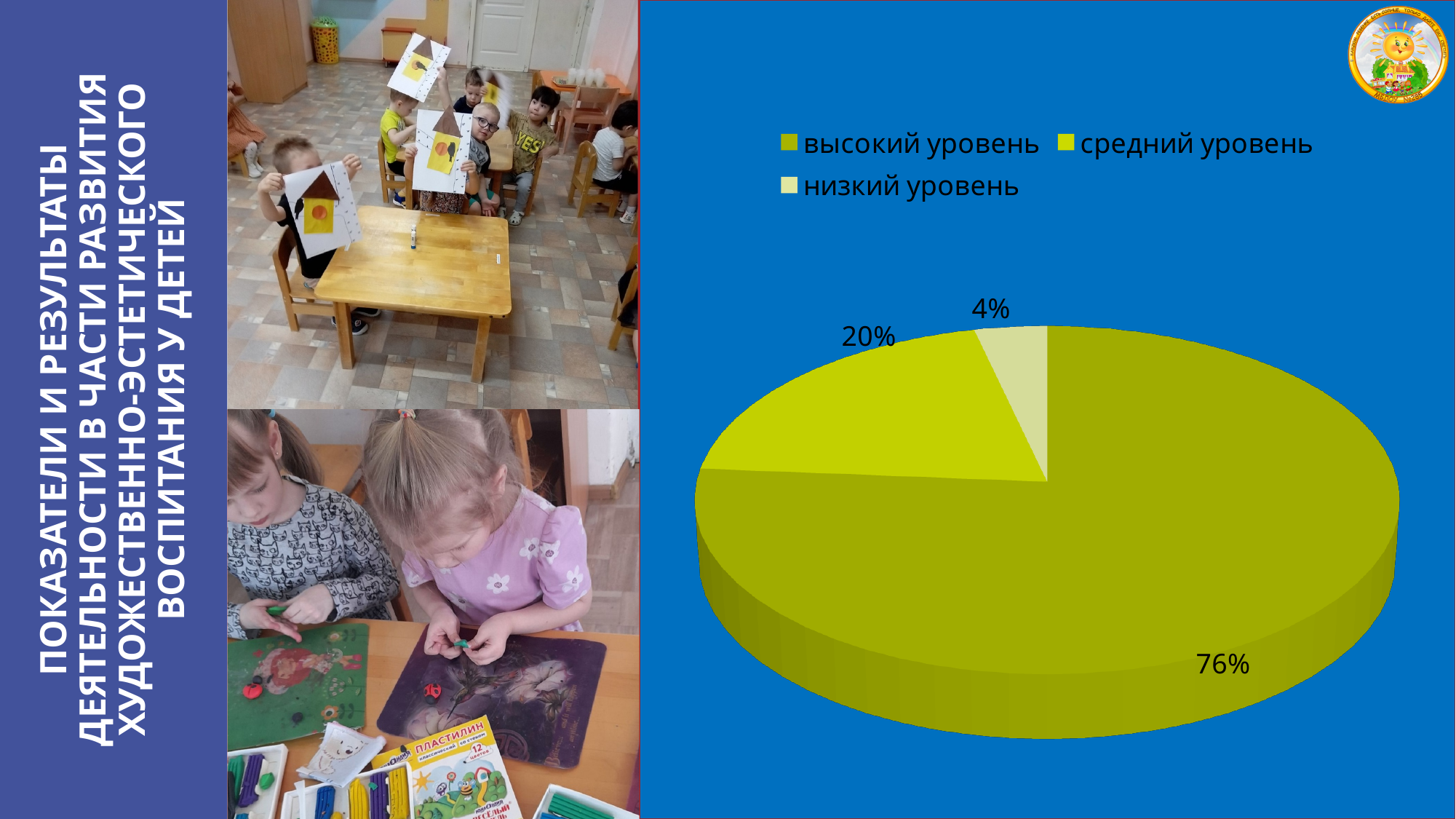
Which category has the largest share of the pie? высокий уровень What percentage is shown for средний уровень? 20% What is the difference in percentage points between средний уровень and низкий уровень? 16 Which category has the smallest share of the pie? низкий уровень What kind of chart is shown on the slide? pie chart What percentage is shown for высокий уровень? 76% What percentage is shown for низкий уровень? 4% How many entries does the legend list? 3 Which legend entry is shown in the lightest colour? низкий уровень Which is larger, the share for средний уровень or the share for низкий уровень? средний уровень What is the difference in percentage points between высокий уровень and средний уровень? 56 How many slices does the pie chart have? 3